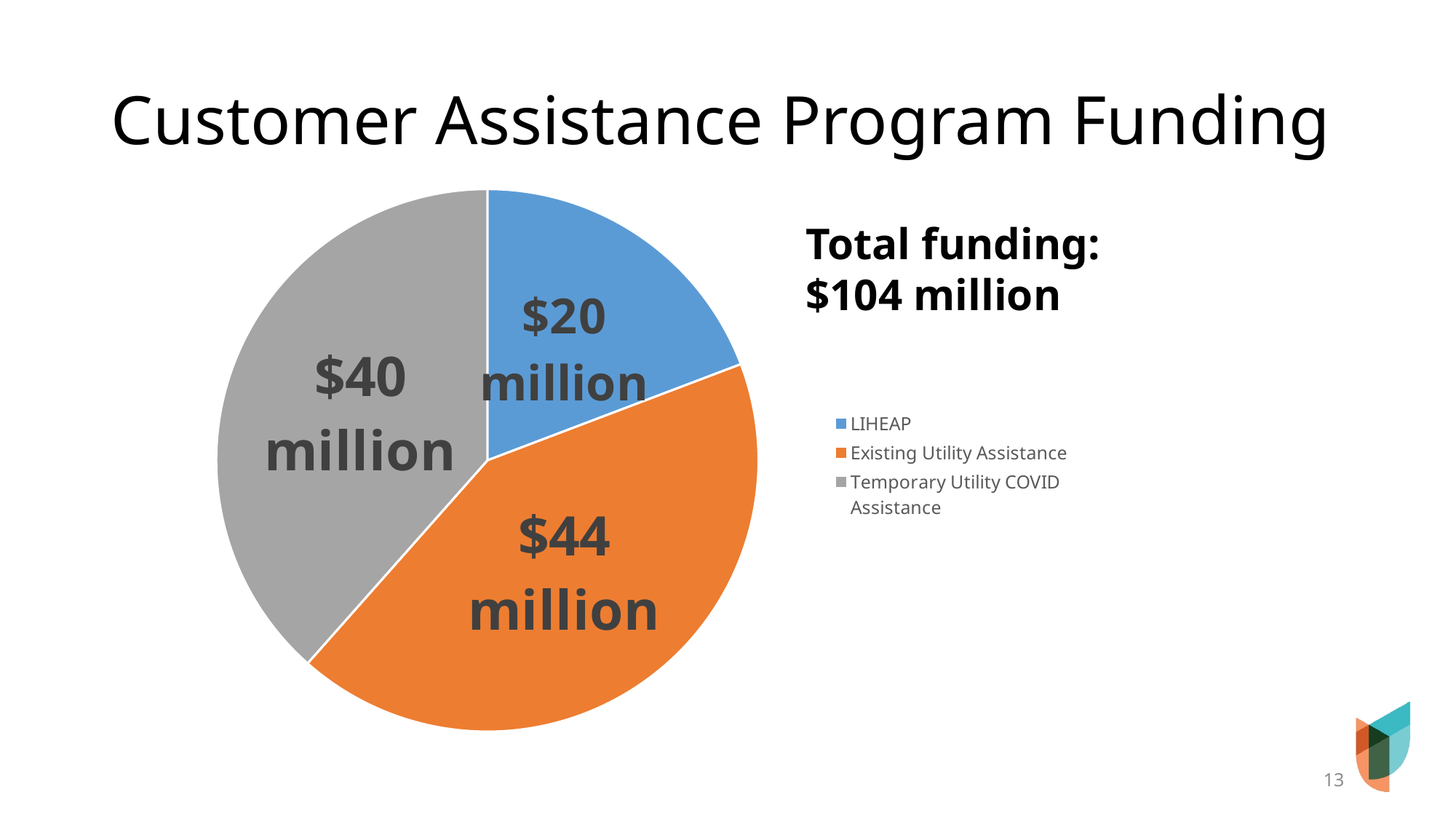
What type of chart is shown on the slide? pie chart What is the funding amount for Existing Utility Assistance? $44 million What is the total funding shown on the slide? $104 million What is the difference between the funding for Temporary Utility COVID Assistance and LIHEAP? $20 million What is the funding amount for LIHEAP? $20 million Which colour represents Existing Utility Assistance in the pie chart? orange Which category has the largest funding amount? Existing Utility Assistance What is the difference between the funding for Existing Utility Assistance and LIHEAP? $24 million What is the funding amount for Temporary Utility COVID Assistance? $40 million Which is larger, the funding for Temporary Utility COVID Assistance or for LIHEAP? Temporary Utility COVID Assistance Which category has the smallest funding amount? LIHEAP How many categories does the pie chart show? 3